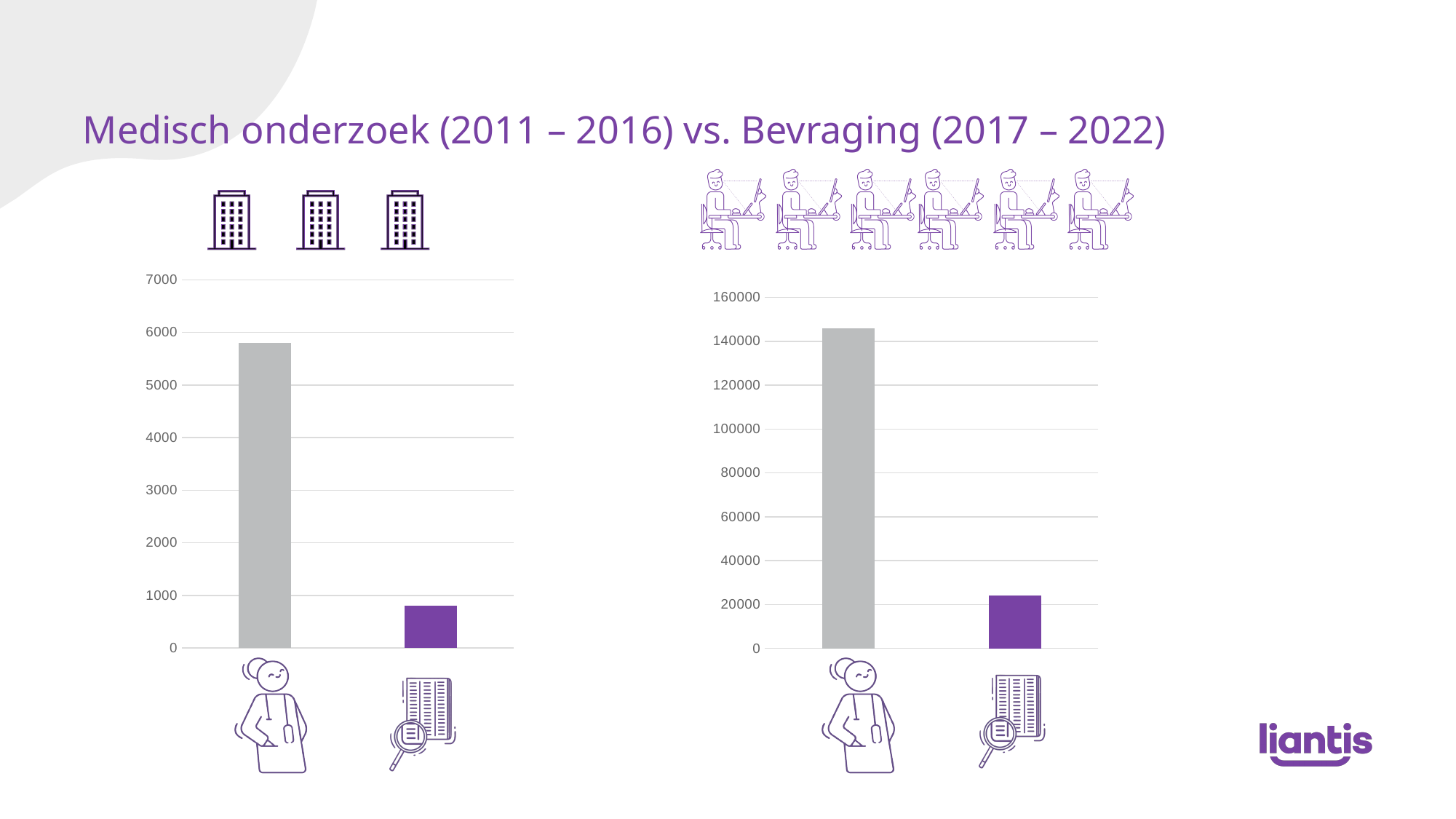
In the right chart, is the value of the purple (right) bar greater or less than 40000? less What kind of chart is the left chart on the slide? bar chart What is the highest value shown on the y axis of the right chart? 160000 In the left chart, is the value of the purple (right) bar greater or less than 1000? less What is the highest value shown on the y axis of the left chart? 7000 In the right chart, which bar is the lowest? the purple (right) bar In the left chart, is the value of the grey (left) bar greater or less than 5000? greater What kind of chart is the right chart on the slide? bar chart How many bars does the right chart show? 2 In the left chart, which bar is taller, the grey bar or the purple bar? the grey bar How many bars does the left chart show? 2